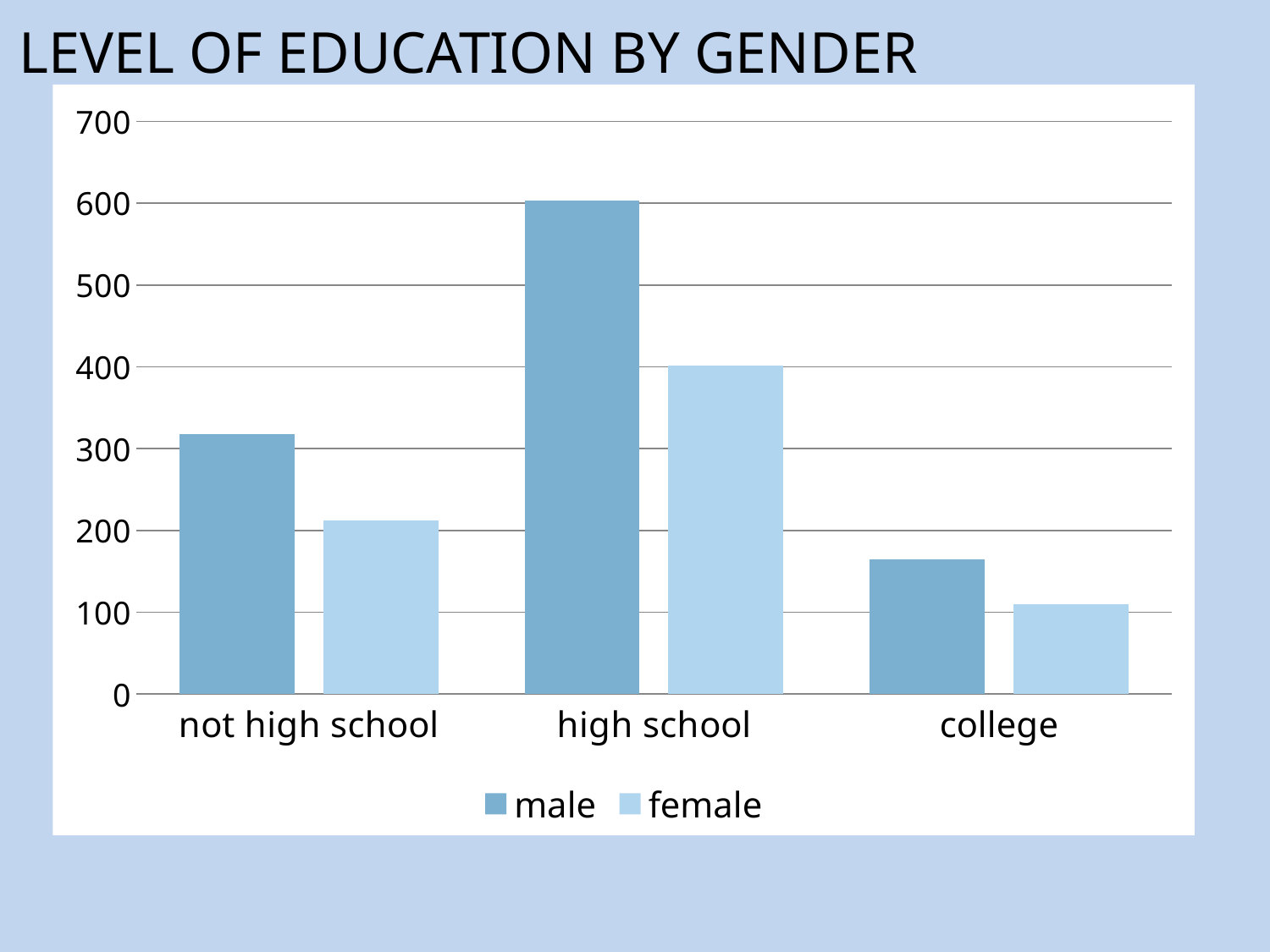
Which is larger for college, the male value or the female value? male Is the male value for not high school greater or less than 300? greater Which is larger, the female value for high school or the male value for not high school? female value for high school Is the female value for not high school greater or less than 300? less What kind of chart is shown on the slide? bar chart What is the title of the chart? LEVEL OF EDUCATION BY GENDER How many education categories are shown on the x axis? 3 How many series does the legend list? 2 Is the male value for college greater or less than 200? less Which education category has the highest male value? high school Which education category has the lowest female value? college